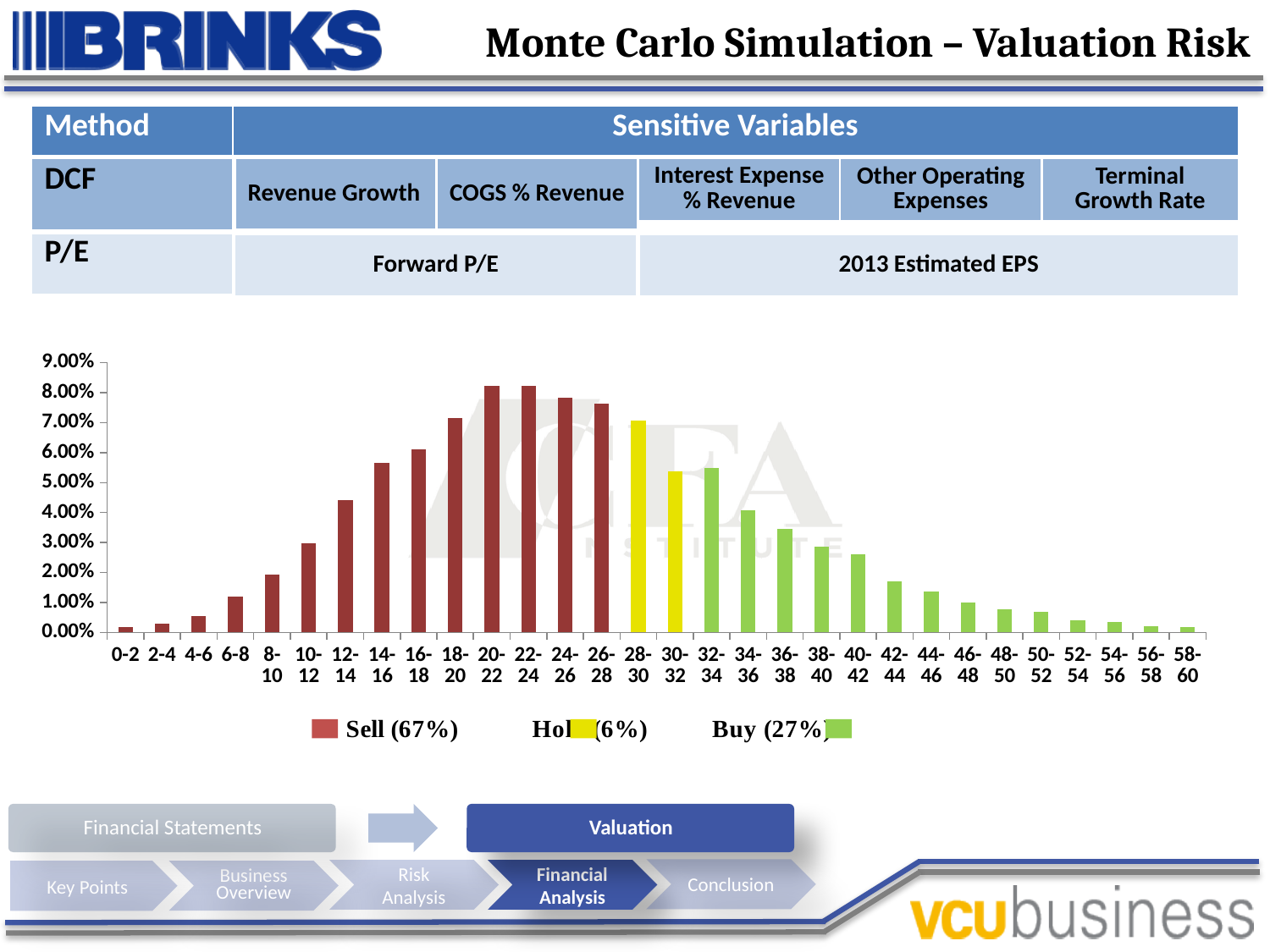
Is the value for the 14-16 bin greater or less than 5.00%? greater How many categories (bins) are shown along the x axis of the chart? 30 Which bin has the larger value, 4-6 or 42-44? 42-44 Is the value for the 20-22 bin greater or less than 8.00%? greater Is the value for the 0-2 bin greater or less than 1.00%? less How many entries does the chart's legend list? 3 Which bin has the larger value, 18-20 or 30-32? 18-20 Do the values rise or fall along the x axis from the 32-34 bin to the 58-60 bin? fall What kind of chart is shown on the slide? bar chart What percentage does the legend show for the Sell category? 67%